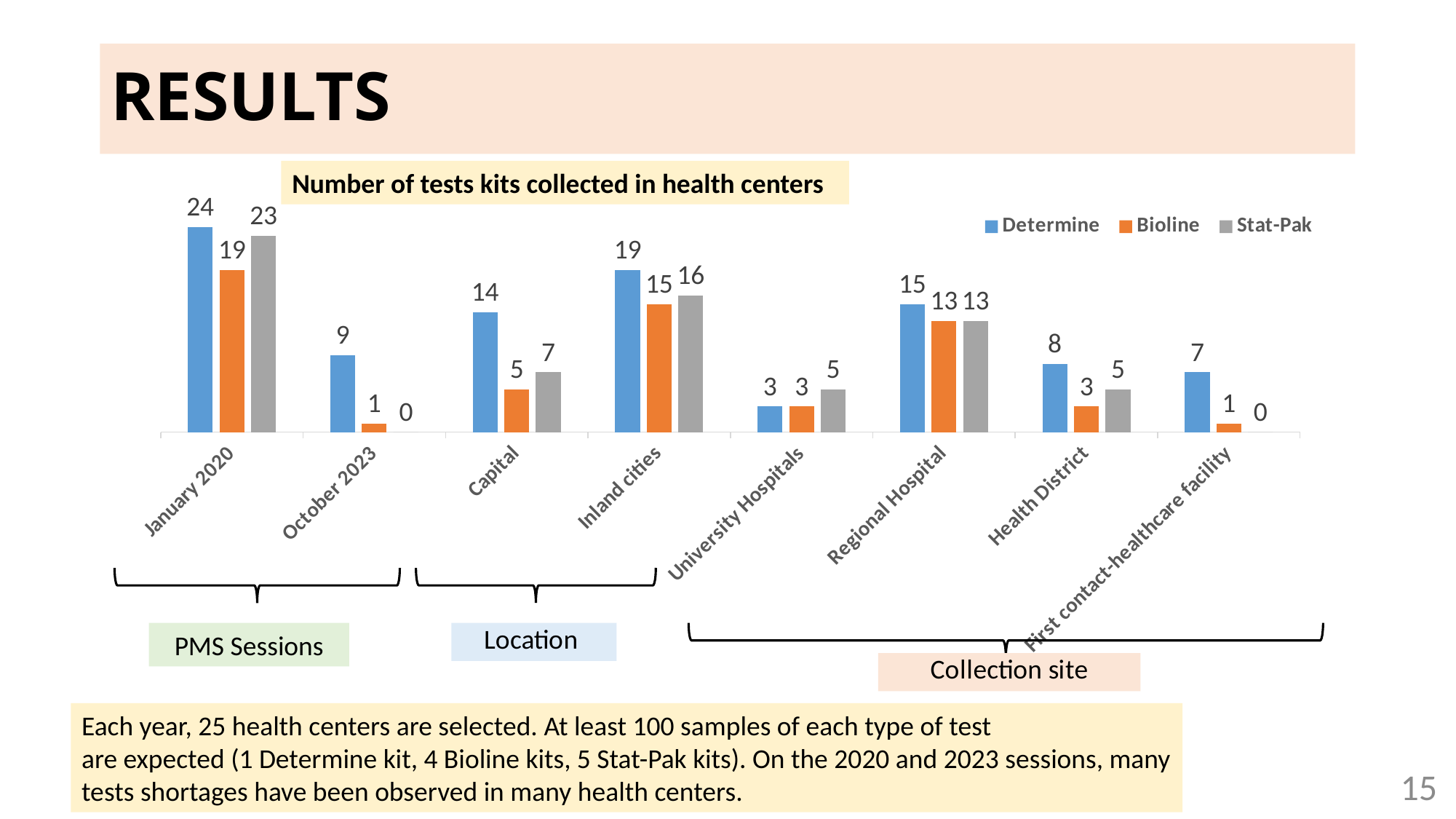
Which is larger, the Stat-Pak value for Regional Hospital or the Stat-Pak value for Health District? Regional Hospital What is the difference between the Determine and Bioline values for Capital? 9 How many categories are shown on the x axis? 8 How many series does the legend list? 3 What is the Bioline value for Inland cities? 15 What kind of chart is shown? bar chart Which category has the lowest Bioline value? October 2023 and First contact-healthcare facility (both 1) What is the Determine value for January 2020? 24 Which colour represents the Bioline series? orange What is the title of the chart? Number of tests kits collected in health centers What is the Stat-Pak value for October 2023? 0 Which category has the highest Determine value? January 2020